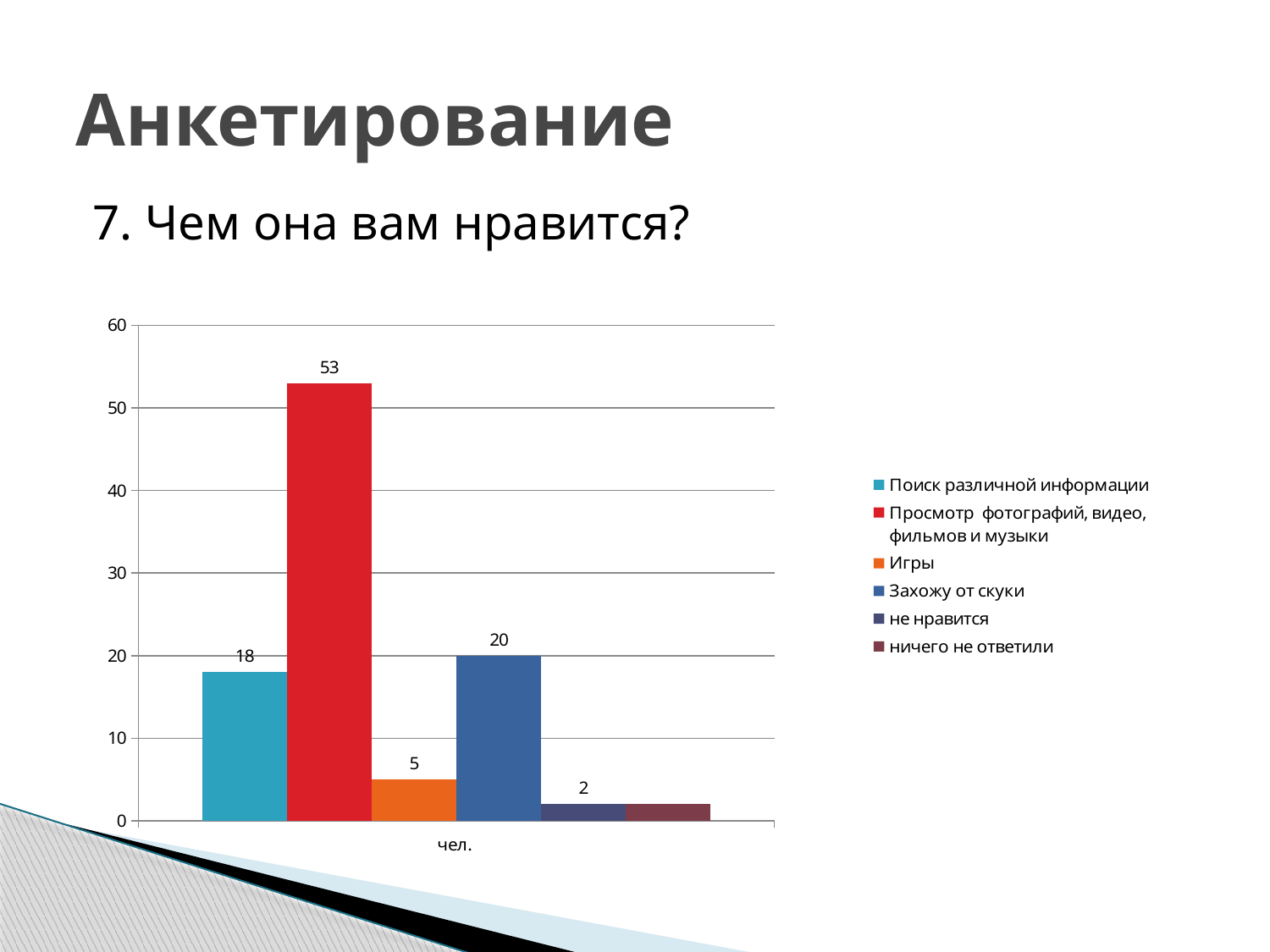
What is the value for "Захожу от скуки"? 20 What is the value for "Игры"? 5 What is the difference between the values for "Просмотр фотографий, видео, фильмов и музыки" and "Захожу от скуки"? 33 What is the value for "Просмотр фотографий, видео, фильмов и музыки"? 53 What is the value for "Поиск различной информации"? 18 What is the value for "не нравится"? 2 What label is shown on the horizontal axis of the chart? чел. Which is larger, the value for "Захожу от скуки" or the value for "Поиск различной информации"? Захожу от скуки Which series has the highest value? Просмотр фотографий, видео, фильмов и музыки Is the value for "ничего не ответили" greater or less than 10? less How many series does the legend list? 6 What kind of chart is shown on the slide? bar chart